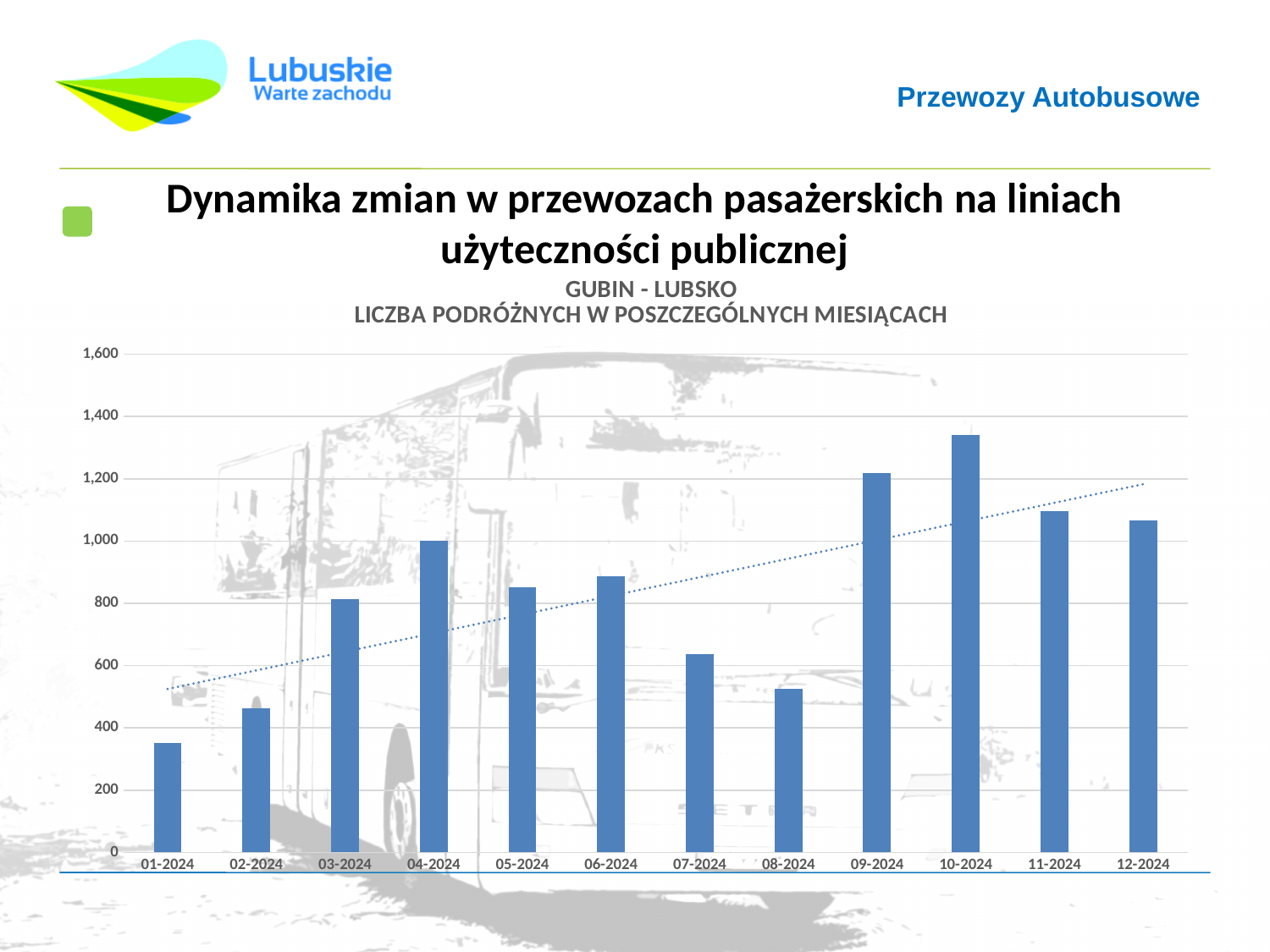
Which month has the larger value, 09-2024 or 12-2024? 09-2024 What kind of chart is shown on the slide? bar chart Which bus route is named in the chart's subtitle? GUBIN - LUBSKO Which month has the larger value, 07-2024 or 08-2024? 07-2024 Is the value for 08-2024 greater or less than 600? less Which month has the lowest number of passengers? 01-2024 Which month has the highest number of passengers? 10-2024 Is the value for 10-2024 greater or less than 1,200? greater Does the dotted trend line rise or fall from 01-2024 to 12-2024? rises Is the value for 01-2024 greater or less than 400? less How many months are plotted on the x axis of the chart? 12